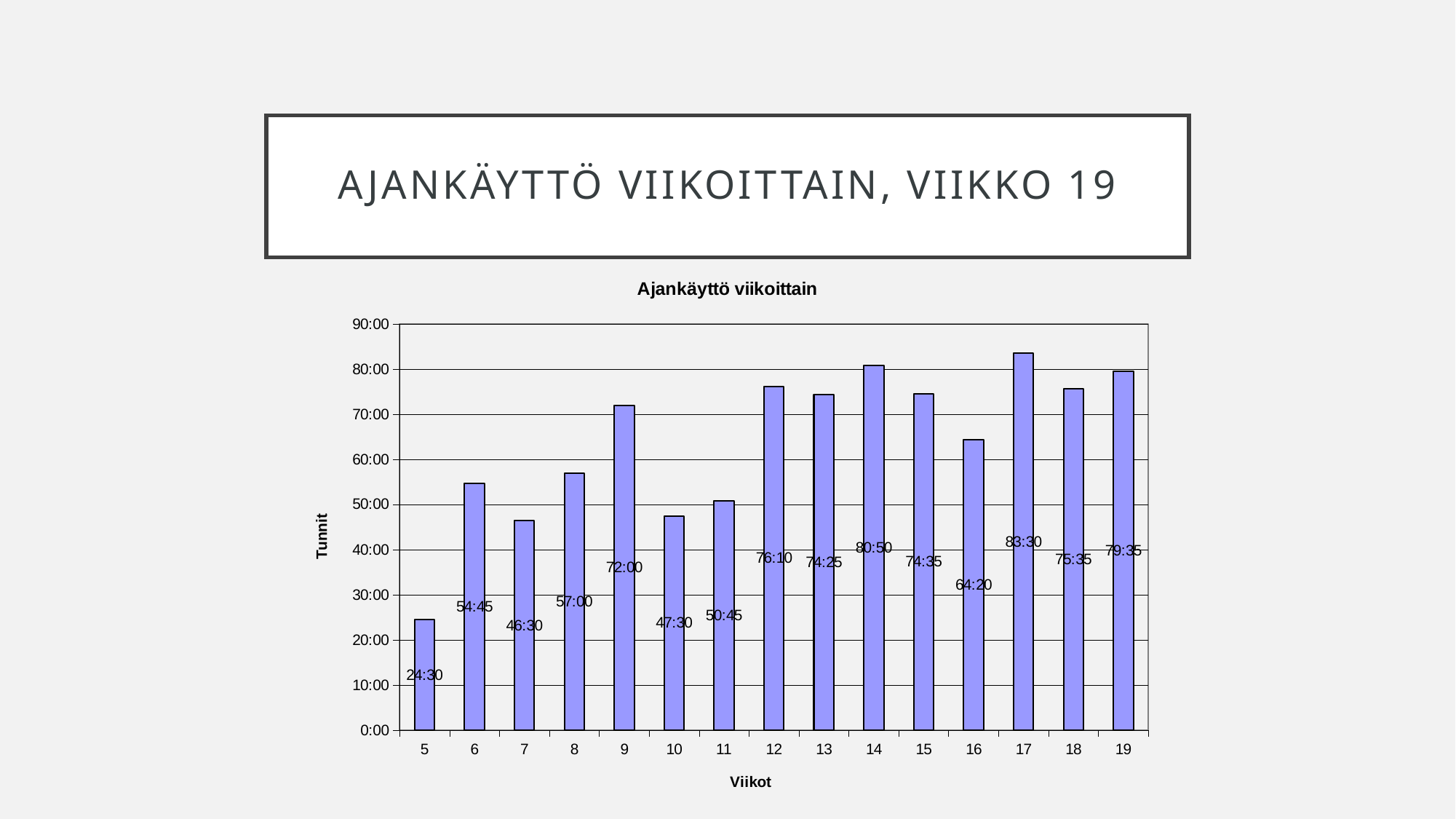
What is the value for week 5 in the Ajankäyttö viikoittain chart? 24:30 What is the label of the y axis in the Ajankäyttö viikoittain chart? Tunnit What is the value for week 19 in the Ajankäyttö viikoittain chart? 79:35 What is the value for week 14 in the Ajankäyttö viikoittain chart? 80:50 Is the value for week 16 in the Ajankäyttö viikoittain chart greater or less than 60:00? greater What is the difference between the values for week 17 and week 5 in the Ajankäyttö viikoittain chart? 59:00 What is the difference between the values for week 9 and week 8 in the Ajankäyttö viikoittain chart? 15:00 Which week has the highest value in the Ajankäyttö viikoittain chart? 17 What kind of chart is the Ajankäyttö viikoittain chart? bar chart Which is larger in the Ajankäyttö viikoittain chart, the value for week 12 or week 15? week 12 Which week has the lowest value in the Ajankäyttö viikoittain chart? 5 How many weeks are shown on the x axis of the Ajankäyttö viikoittain chart? 15